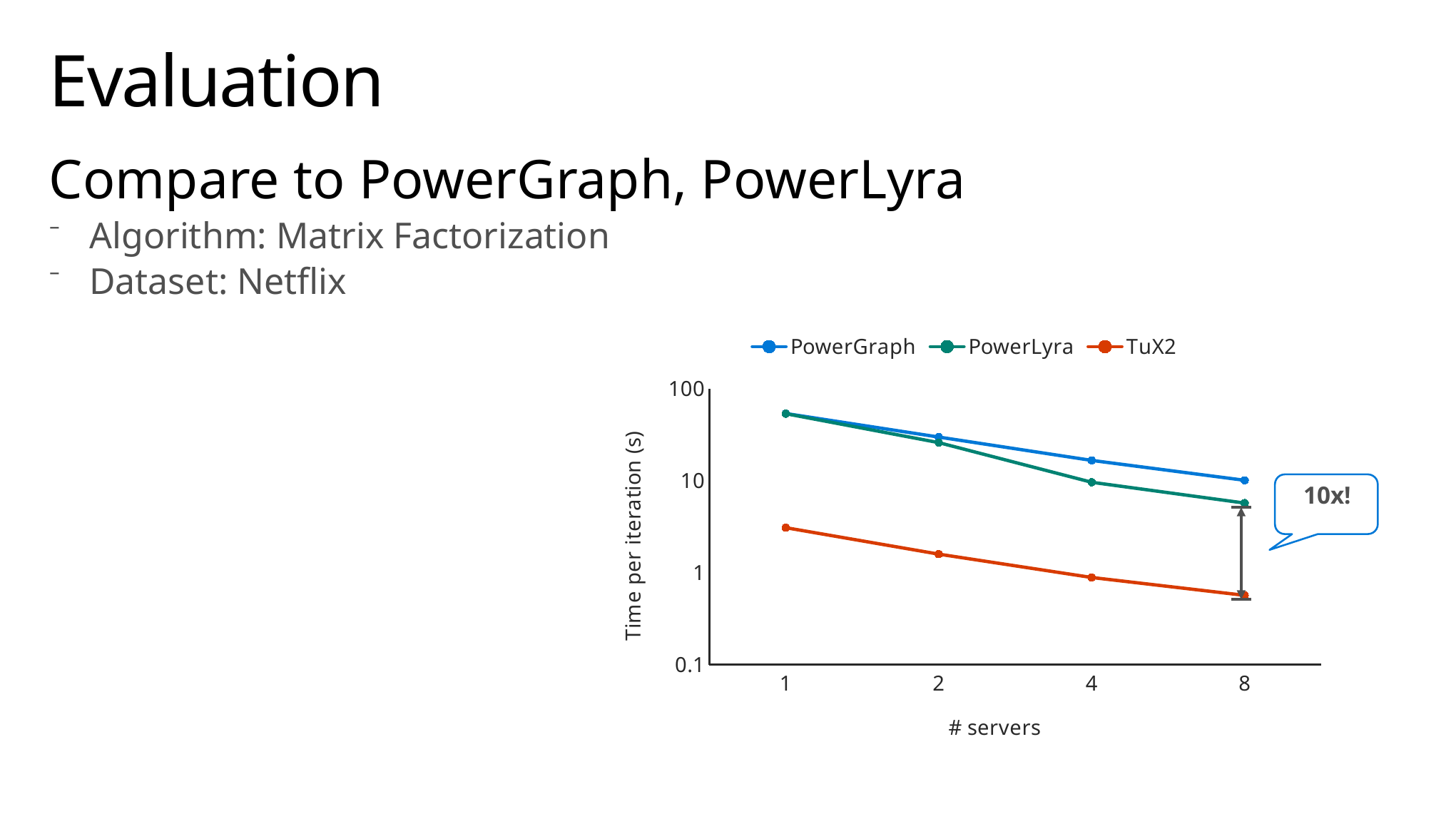
How many series does the chart legend list? 3 Does the time per iteration for TuX2 rise or fall as the number of servers increases? fall What does the callout next to the 8-server points say? 10x! Is the time per iteration for TuX2 at 1 server greater or less than 1? greater Which series has the highest time per iteration at 8 servers? PowerGraph What is the label of the x axis? # servers At 8 servers, which has the larger time per iteration, PowerGraph or TuX2? PowerGraph What kind of chart is shown on the slide? line chart Is the time per iteration for PowerGraph at 4 servers greater or less than 10? greater Is the time per iteration for TuX2 at 8 servers greater or less than 1? less How many server counts are plotted along the x axis? 4 Which series has the lowest time per iteration at 8 servers? TuX2